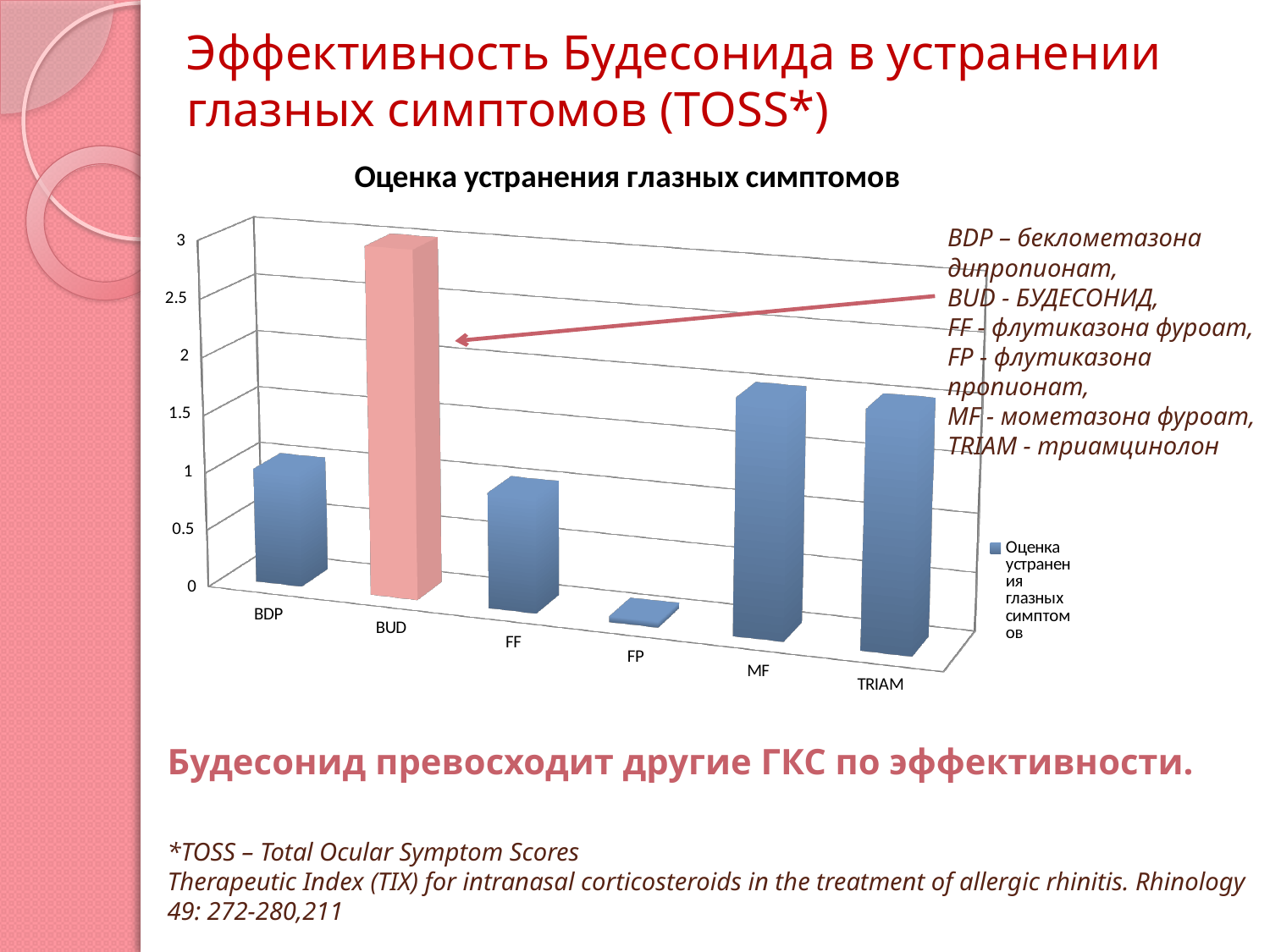
Which category has the lowest bar in the chart? FP How many series does the chart legend list? 1 Is the value for BUD greater or less than 2? greater Which is larger, the value for BUD or the value for BDP? BUD Which category has the highest bar in the chart? BUD Is the value for MF greater or less than 1? greater What is the title of the chart? Оценка устранения глазных симптомов How many categories are shown on the x axis of the chart? 6 Is the value for BDP greater or less than 2? less Which bar in the chart is coloured differently (pink) from the others? BUD What kind of chart is shown on the slide? Bar chart